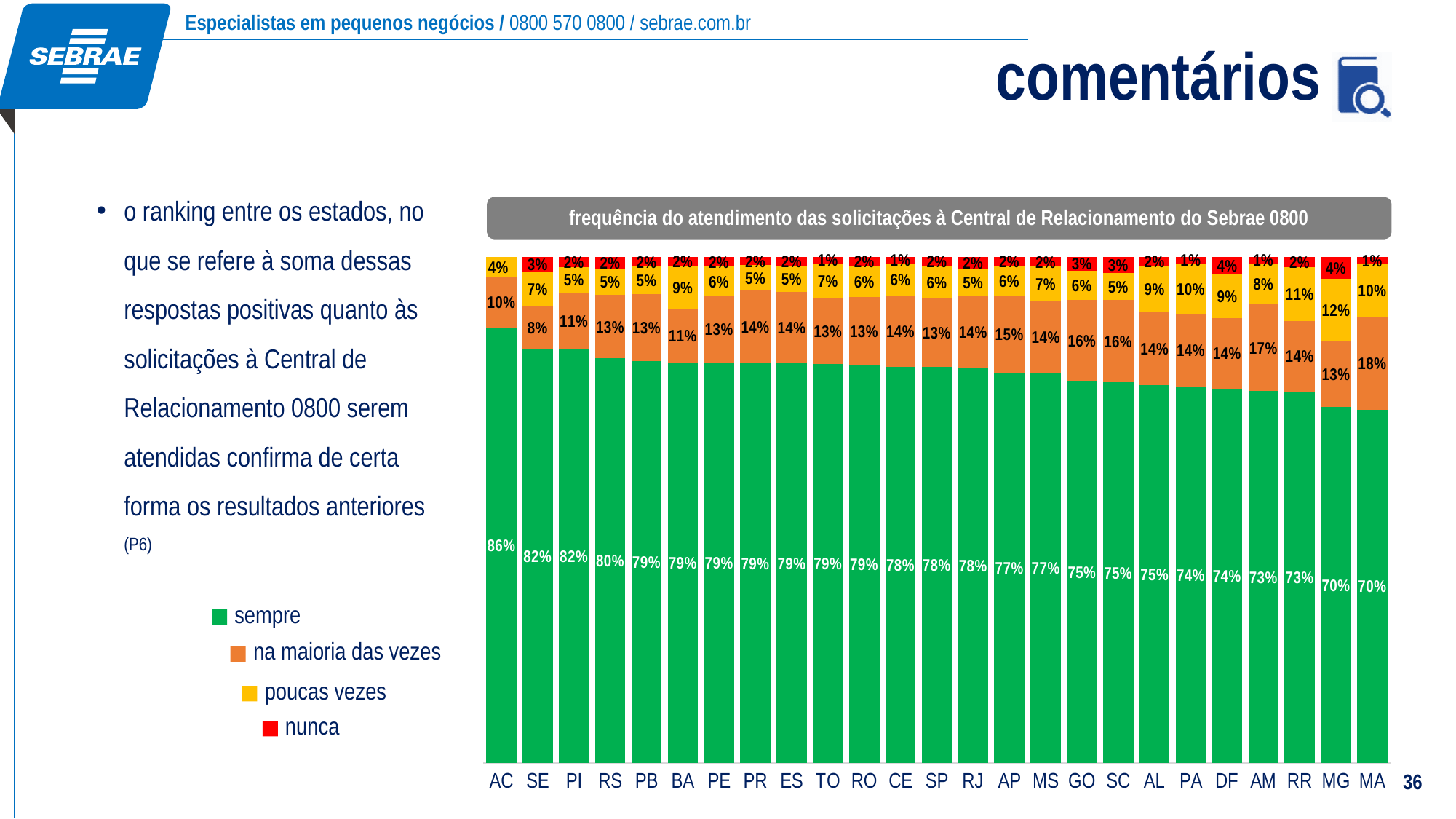
What kind of chart is shown on the slide? Stacked bar chart How many series does the legend list? 4 What is the difference between the "sempre" value for AC and the "sempre" value for MA? 16 percentage points What is the value of "poucas vezes" for MG? 12% How many states are shown on the x axis of the chart? 25 What is the value of "sempre" for AC? 86% Which state has the highest value for "sempre"? AC Which state has the highest value for "na maioria das vezes"? MA Which state has a larger "sempre" value, SE or GO? SE What is the value of "nunca" for DF? 4% What is the value of "na maioria das vezes" for MA? 18% Do the "sempre" values rise or fall from left to right along the x axis? Fall